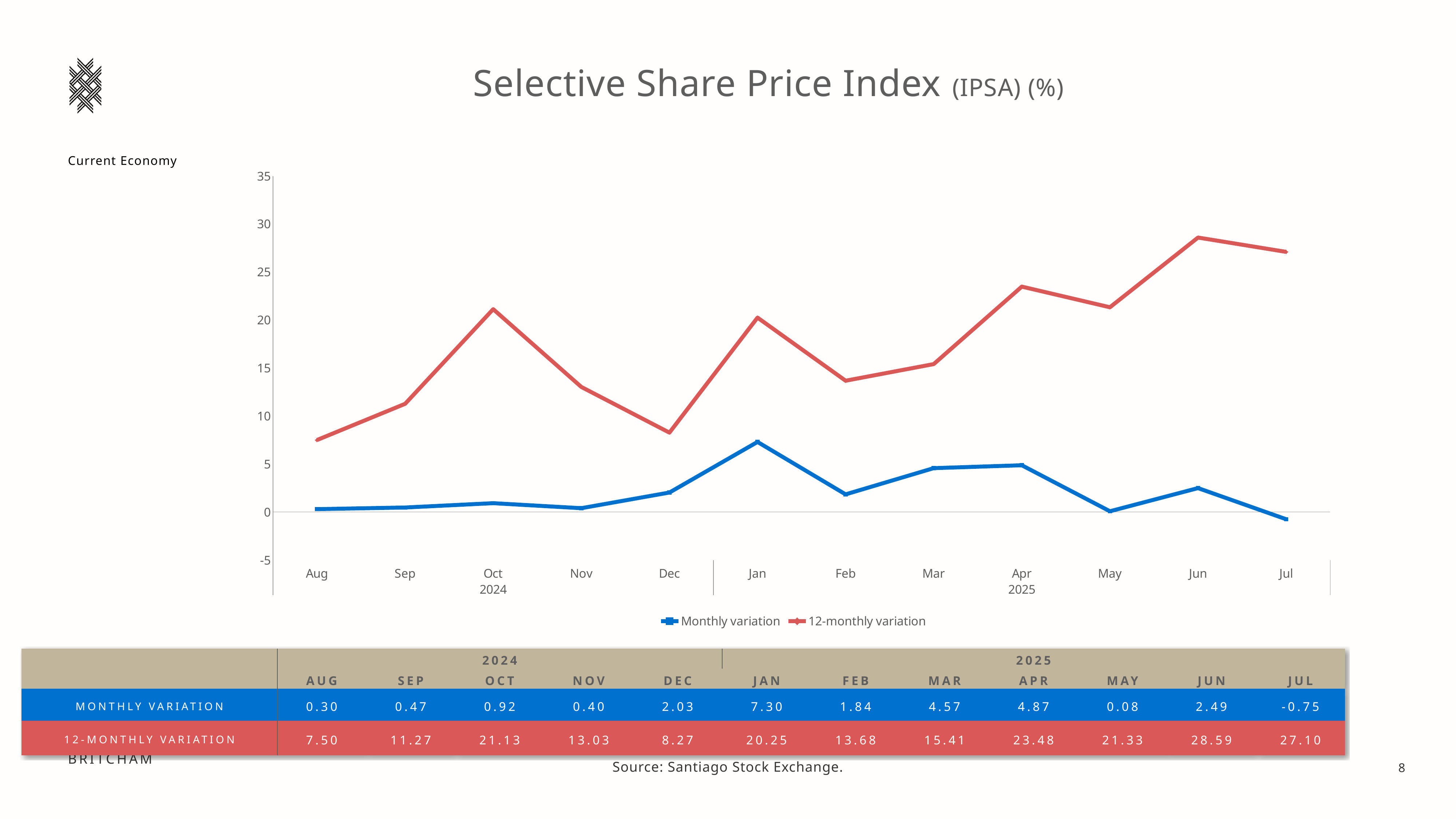
Does the 12-monthly variation rise or fall from Feb 2025 to Jun 2025? Rise What is the monthly variation for Jul 2025? -0.75 In which month is the monthly variation lowest? Jul 2025 What type of chart is shown on the slide? Line chart What is the difference between the 12-monthly variation in Jun 2025 and Jul 2025? 1.49 What is the 12-monthly variation for Oct 2024? 21.13 In which month is the 12-monthly variation highest? Jun 2025 What is the monthly variation for Jan 2025? 7.30 How many months are plotted along the x axis? 12 Which is larger, the 12-monthly variation in Apr 2025 or in May 2025? Apr 2025 In which month is the 12-monthly variation lowest? Aug 2024 How many series does the legend list? 2